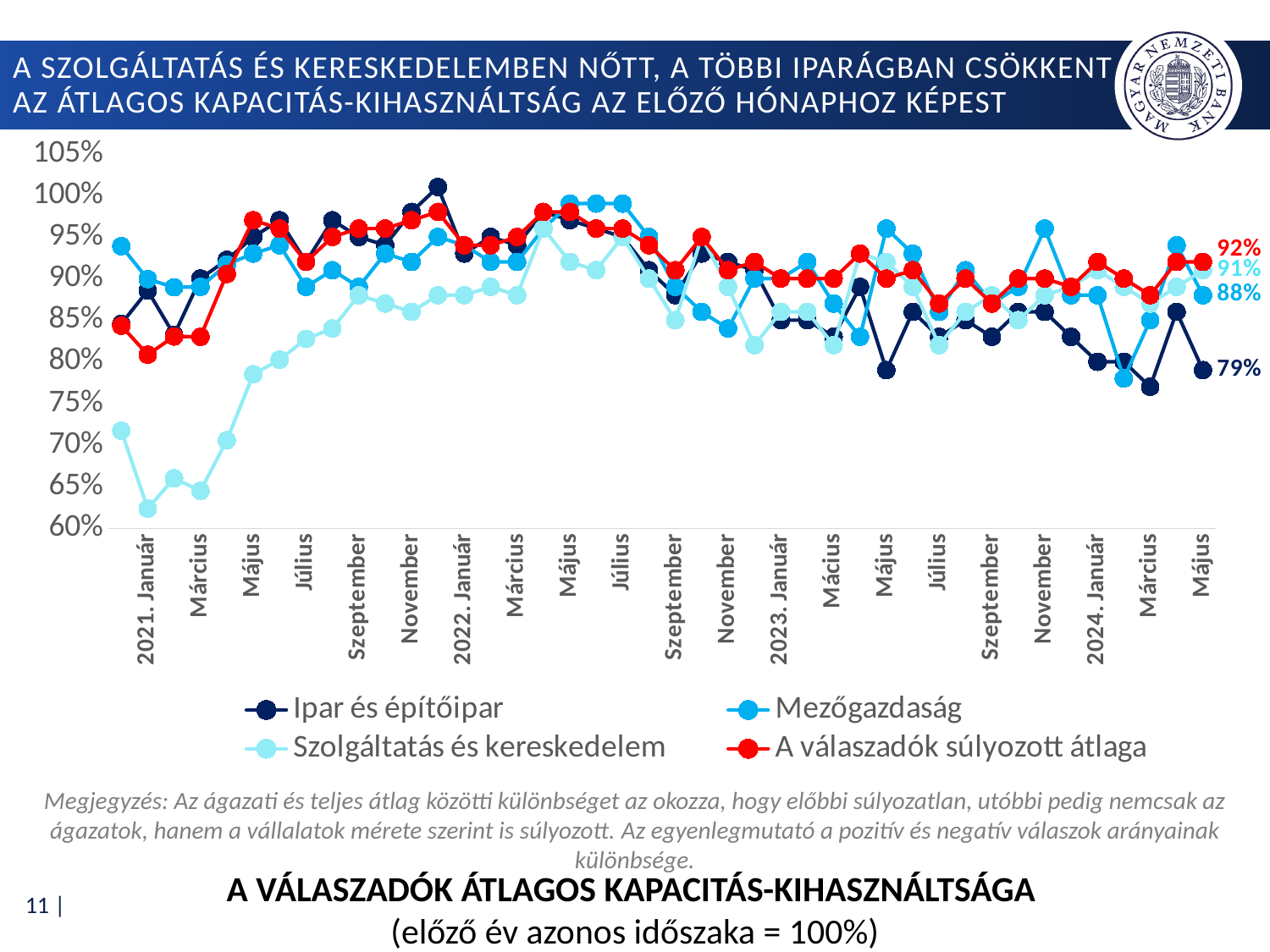
At May 2024, which is higher: 'Mezőgazdaság' or 'Ipar és építőipar'? Mezőgazdaság What is the latest value shown for 'Ipar és építőipar' (May 2024)? 79% Which series has the lowest value at the last data point (May 2024)? Ipar és építőipar What is the latest value shown for 'Szolgáltatás és kereskedelem' (May 2024)? 91% How many series does the legend list? 4 What is the latest value shown for 'Mezőgazdaság' (May 2024)? 88% Which series has the highest value at the last data point (May 2024)? A válaszadók súlyozott átlaga Does the 'Szolgáltatás és kereskedelem' series rise or fall between 2021. Január and 2022. Május? Rise What kind of chart is shown on the slide? Line chart What is the latest value shown for 'A válaszadók súlyozott átlaga' (May 2024)? 92% What is the difference between the May 2024 values of 'A válaszadók súlyozott átlaga' and 'Ipar és építőipar'? 13 percentage points Is the value for 'Szolgáltatás és kereskedelem' in 2021. Január greater or less than 75%? less